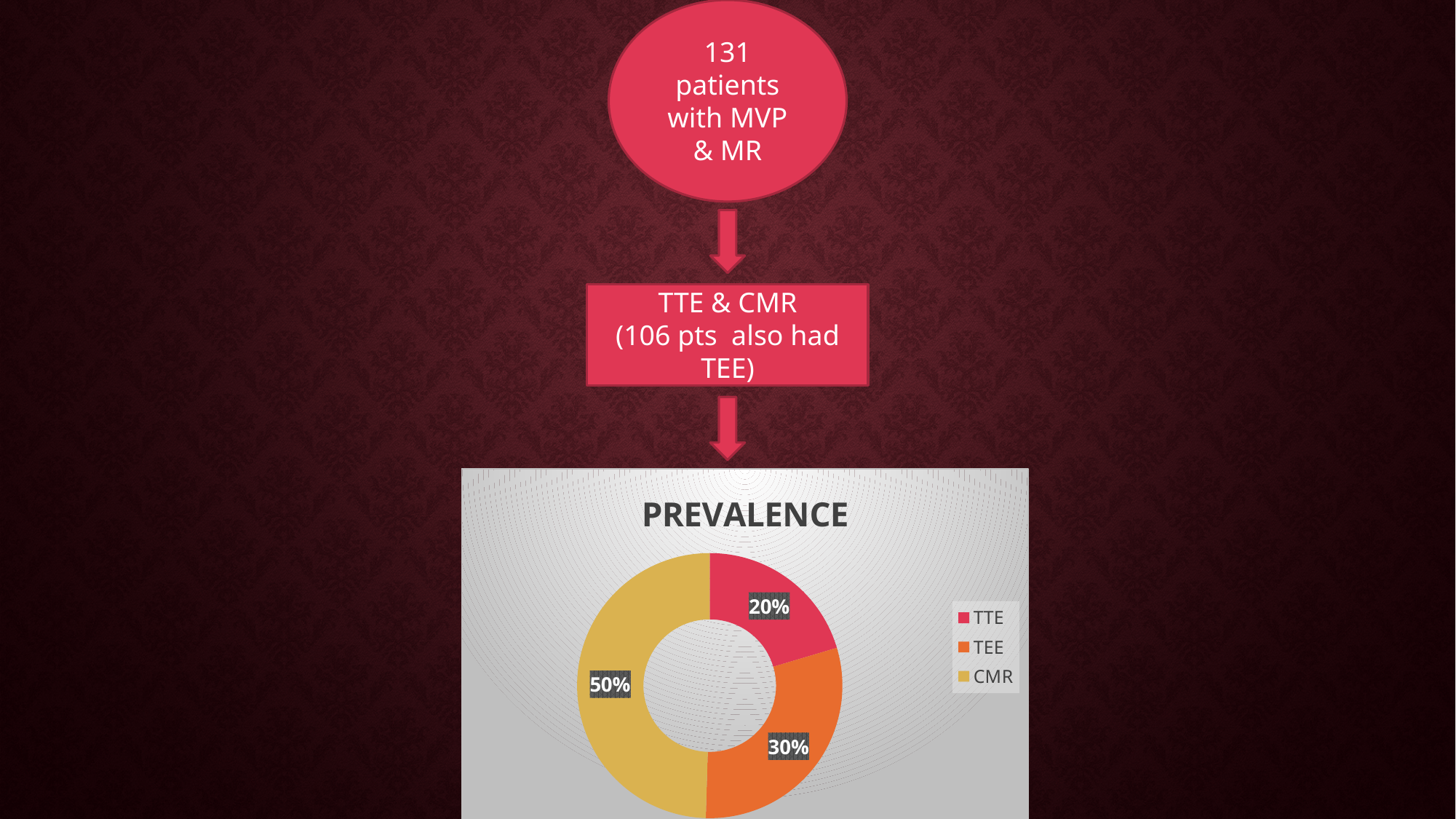
What share of the chart do TTE and TEE together make up? 50% Which category has the largest share of the chart? CMR What kind of chart is shown on the slide? Doughnut (pie) chart How many categories does the legend list? 3 What colour is the CMR slice in the chart? Yellow (gold) Which category has the smallest share of the chart? TTE What is the title of the chart on the slide? PREVALENCE What is the difference in percentage points between the CMR and TTE slices? 30 percentage points What percentage does the TTE slice show? 20% What percentage does the TEE slice show? 30% What percentage does the CMR slice show? 50% Which is larger, the TEE slice or the TTE slice? TEE